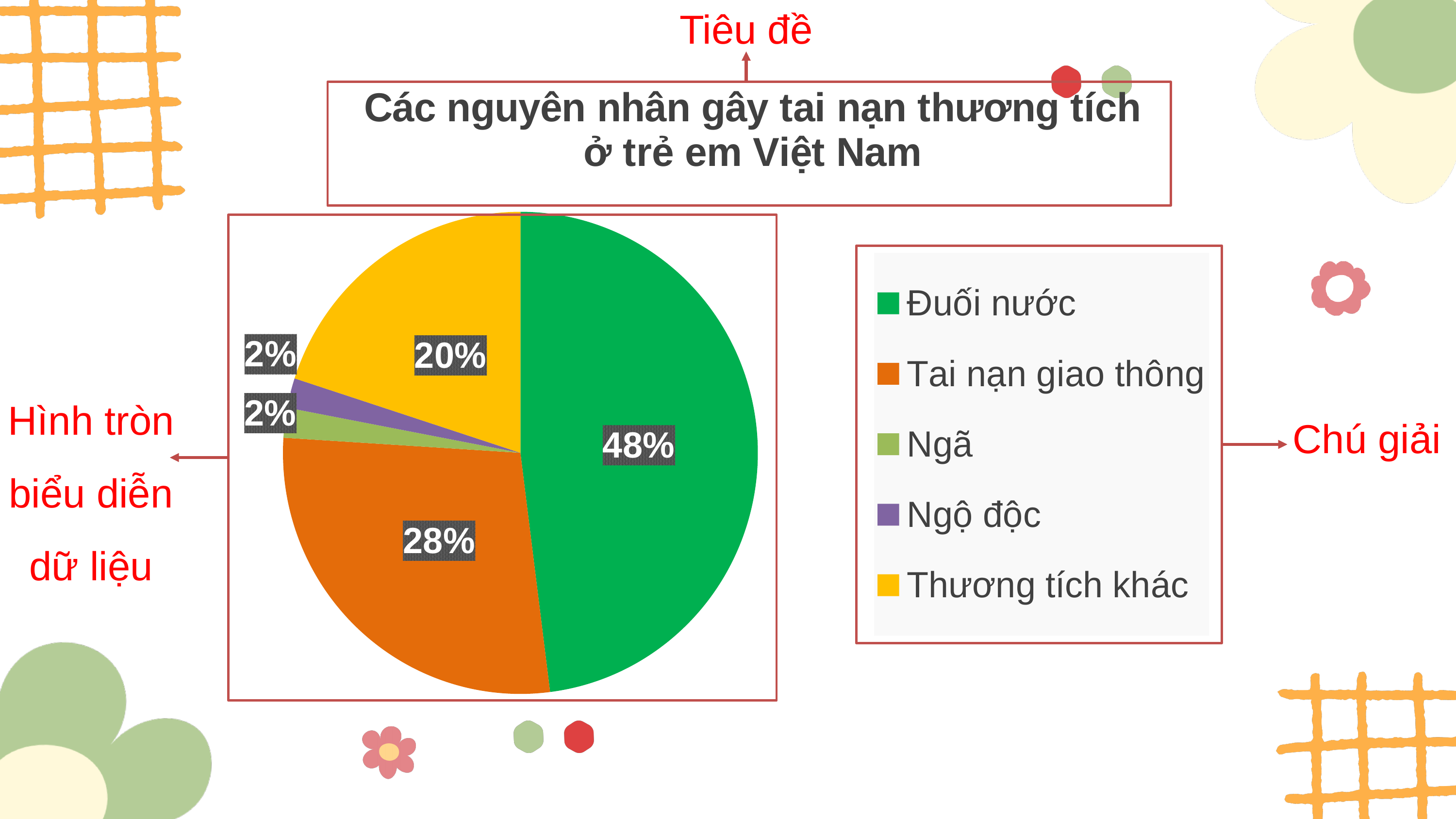
What is the combined share of Đuối nước and Tai nạn giao thông? 76% Which category has the largest slice of the pie? Đuối nước What kind of chart is shown on the slide? pie chart Which is larger, the Thương tích khác slice or the Tai nạn giao thông slice? Tai nạn giao thông What is the difference between the Đuối nước and Tai nạn giao thông shares? 20% What percentage of the pie is Thương tích khác? 20% How many categories does the legend list? 5 What is the title of the chart? Các nguyên nhân gây tai nạn thương tích ở trẻ em Việt Nam What percentage of the pie is Ngộ độc? 2% Which colour represents Ngã in the legend? light green What percentage of the pie is Tai nạn giao thông? 28% What percentage of the pie is Đuối nước? 48%